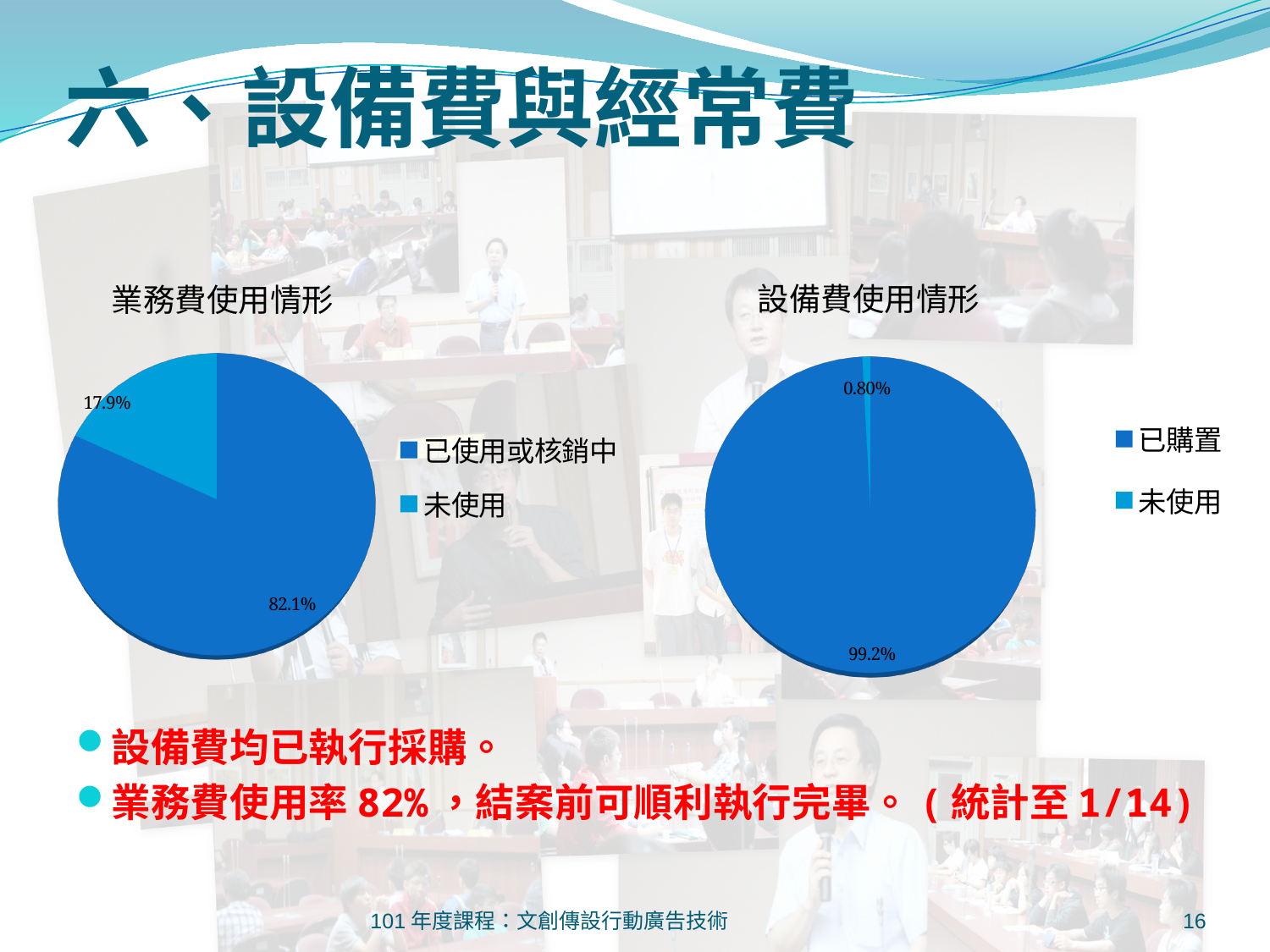
In the chart titled 設備費使用情形, what is the difference between the 已購置 and 未使用 shares? 98.4% In the chart titled 設備費使用情形, what is the share for 已購置? 99.2% In the chart titled 業務費使用情形, what is the share for 未使用? 17.9% How many categories does the legend of the chart titled 業務費使用情形 list? 2 Which is larger: the 未使用 share in the 業務費使用情形 chart or the 未使用 share in the 設備費使用情形 chart? 業務費使用情形 In the chart titled 業務費使用情形, what is the difference between the 已使用或核銷中 and 未使用 shares? 64.2% In the chart titled 業務費使用情形, what is the share for 已使用或核銷中? 82.1% In the chart titled 設備費使用情形, what is the share for 未使用? 0.80% What is the title of the pie chart on the right side of the slide? 設備費使用情形 What type of chart is the chart titled 設備費使用情形? Pie chart In the chart titled 設備費使用情形, which category has the smallest slice? 未使用 In the chart titled 業務費使用情形, which category has the largest slice? 已使用或核銷中